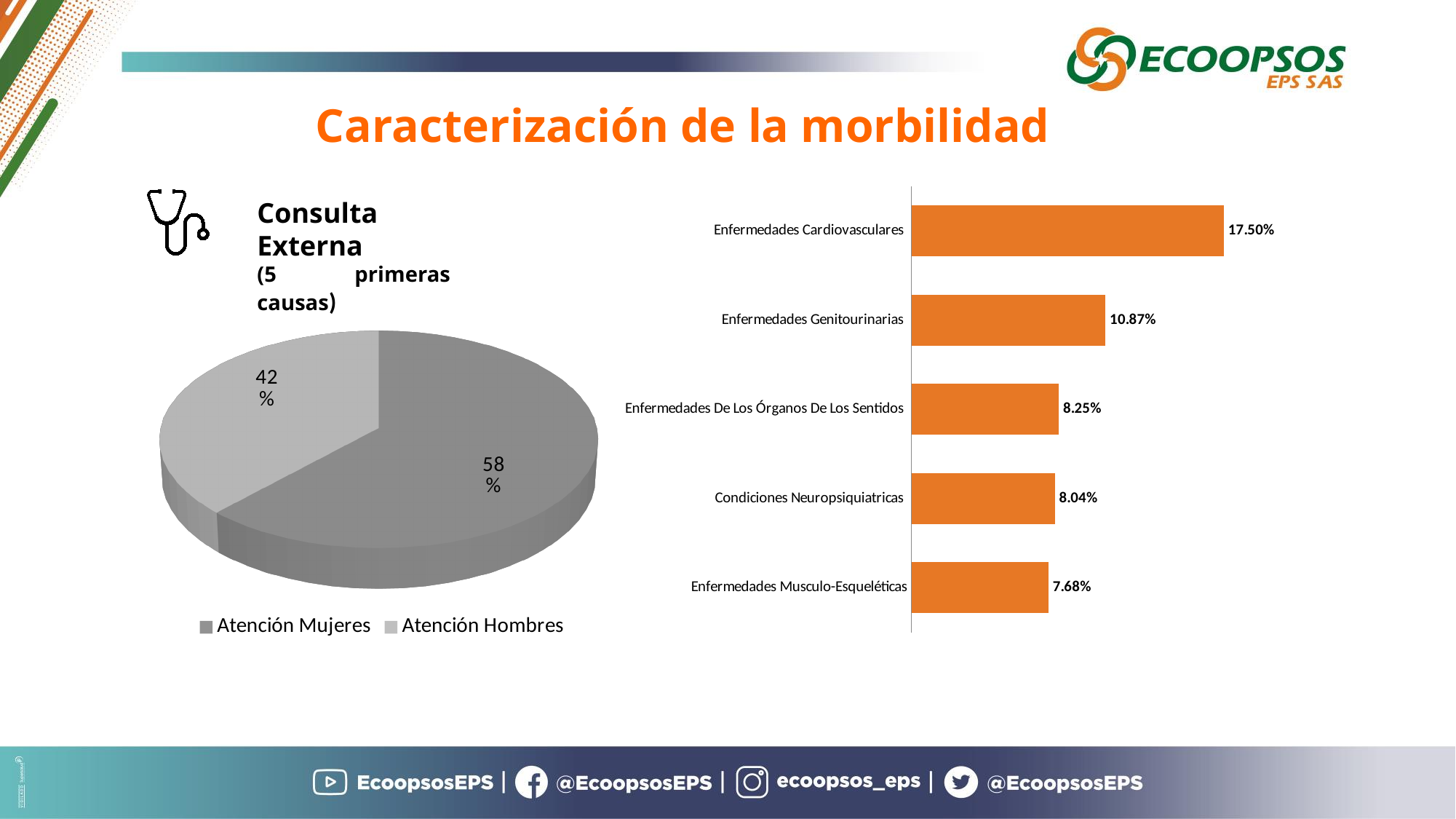
In the bar chart on the right, what is the value for Enfermedades Genitourinarias? 10.87% In the pie chart on the left, what share is labelled for Atención Mujeres? 58% In the bar chart on the right, which category has the lowest value? Enfermedades Musculo-Esqueléticas What kind of chart is shown on the left of the slide? Pie chart In the bar chart on the right, what is the value for Condiciones Neuropsiquiatricas? 8.04% In the bar chart on the right, which category has the highest value? Enfermedades Cardiovasculares In the pie chart on the left, which slice is larger, Atención Mujeres or Atención Hombres? Atención Mujeres In the bar chart on the right, what is the value for Enfermedades Cardiovasculares? 17.50% In the bar chart on the right, what is the difference between Enfermedades Cardiovasculares and Enfermedades Genitourinarias? 6.63% In the pie chart on the left, how many entries does the legend list? 2 How many categories are shown in the bar chart on the right? 5 In the pie chart on the left, what share is labelled for Atención Hombres? 42%